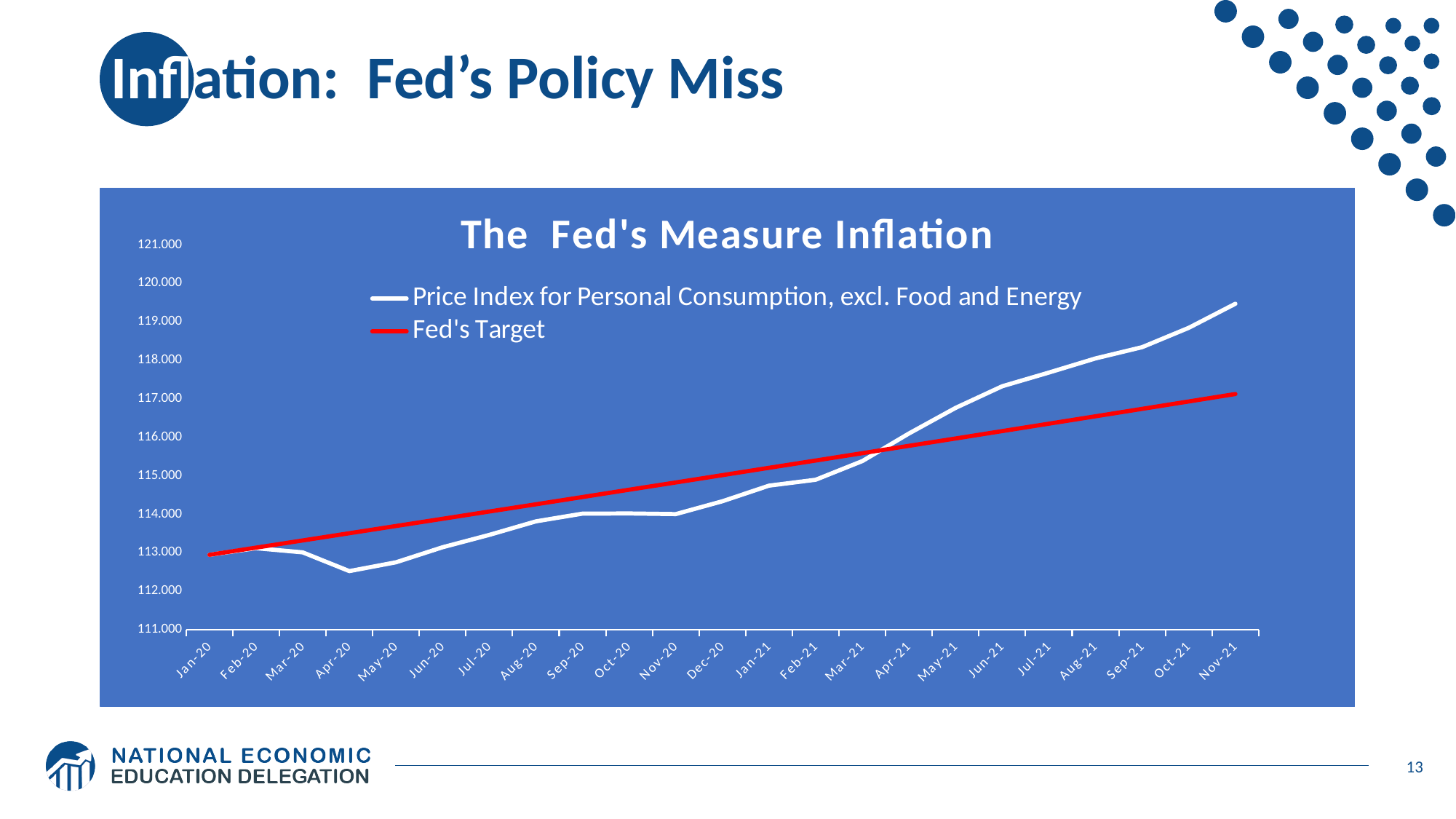
What kind of chart is shown on the slide? line chart Which series is drawn in red? Fed's Target Is the value of the Price Index for Personal Consumption, excl. Food and Energy at Nov-21 greater or less than 118.000? greater In which month does the Price Index for Personal Consumption, excl. Food and Energy reach its highest value? Nov-21 At Oct-20, which series is higher: the Price Index for Personal Consumption, excl. Food and Energy or the Fed's Target? Fed's Target What is the title of the chart? The Fed's Measure Inflation How many series does the legend list? 2 Does the Fed's Target line rise or fall from Jan-20 to Nov-21? rise At Nov-21, which series is higher: the Price Index for Personal Consumption, excl. Food and Energy or the Fed's Target? Price Index for Personal Consumption, excl. Food and Energy Is the value of the Fed's Target at Nov-21 greater or less than 118.000? less In which month does the Price Index for Personal Consumption, excl. Food and Energy reach its lowest value? Apr-20 How many months are plotted along the x axis? 23